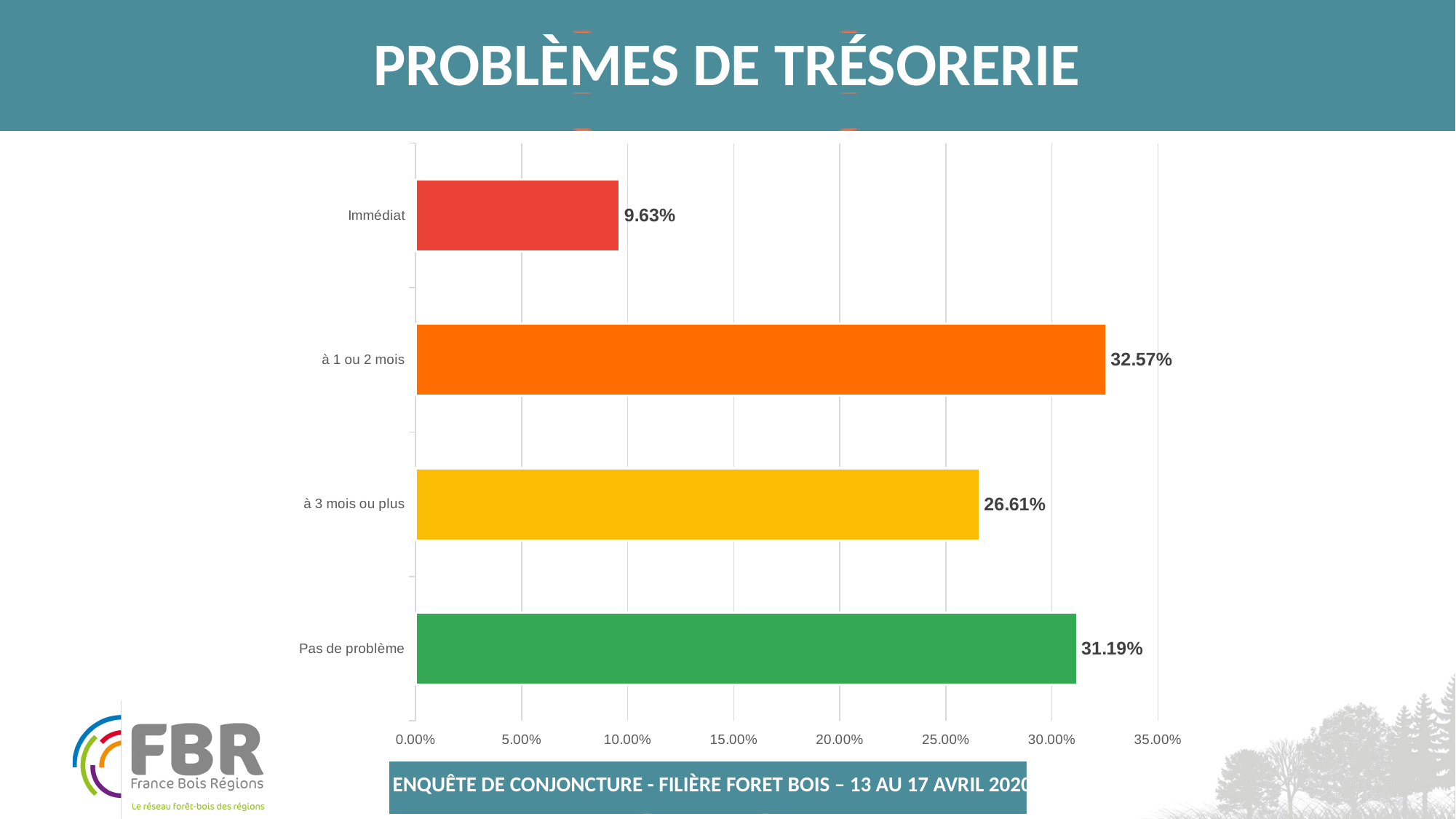
Which category has the lowest value? Immédiat What is the difference between the values for "à 1 ou 2 mois" and "Pas de problème"? 1.38% What is the value for "Immédiat"? 9.63% What is the difference between the values for "à 3 mois ou plus" and "Immédiat"? 16.98% Which is larger, the value for "à 3 mois ou plus" or the value for "Pas de problème"? Pas de problème Is the value for "Immédiat" greater or less than 10.00%? less What is the value for "à 3 mois ou plus"? 26.61% What is the value for "à 1 ou 2 mois"? 32.57% What kind of chart is shown on the slide? bar chart Which category has the highest value? à 1 ou 2 mois What is the value for "Pas de problème"? 31.19% How many categories are shown in the chart? 4